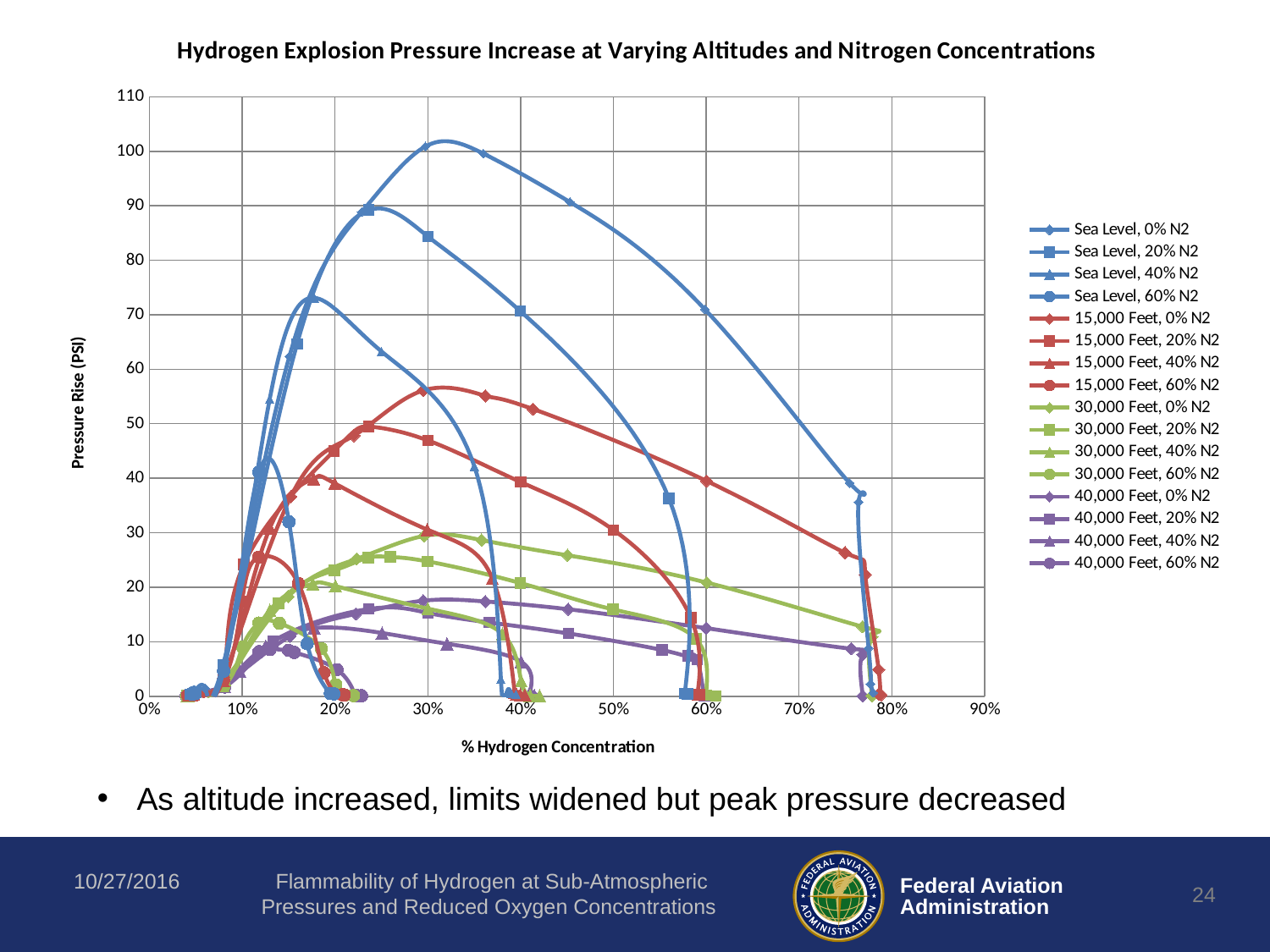
Which series has the lowest peak pressure rise on the chart? 40,000 Feet, 60% N2 What kind of chart is shown on the slide? Line chart How many series does the legend list? 16 Is the peak pressure rise for the 40,000 Feet, 0% N2 series greater or less than 20? less What is the label of the vertical axis? Pressure Rise (PSI) Which series reaches the highest pressure rise on the chart? Sea Level, 0% N2 Is the peak pressure rise for the 15,000 Feet, 0% N2 series greater or less than 50? greater What is the title of the chart? Hydrogen Explosion Pressure Increase at Varying Altitudes and Nitrogen Concentrations Which series has a higher peak pressure rise: Sea Level, 20% N2 or 15,000 Feet, 0% N2? Sea Level, 20% N2 Which series has a higher peak pressure rise: 30,000 Feet, 0% N2 or 40,000 Feet, 0% N2? 30,000 Feet, 0% N2 Is the peak pressure rise for the Sea Level, 0% N2 series greater or less than 90? greater